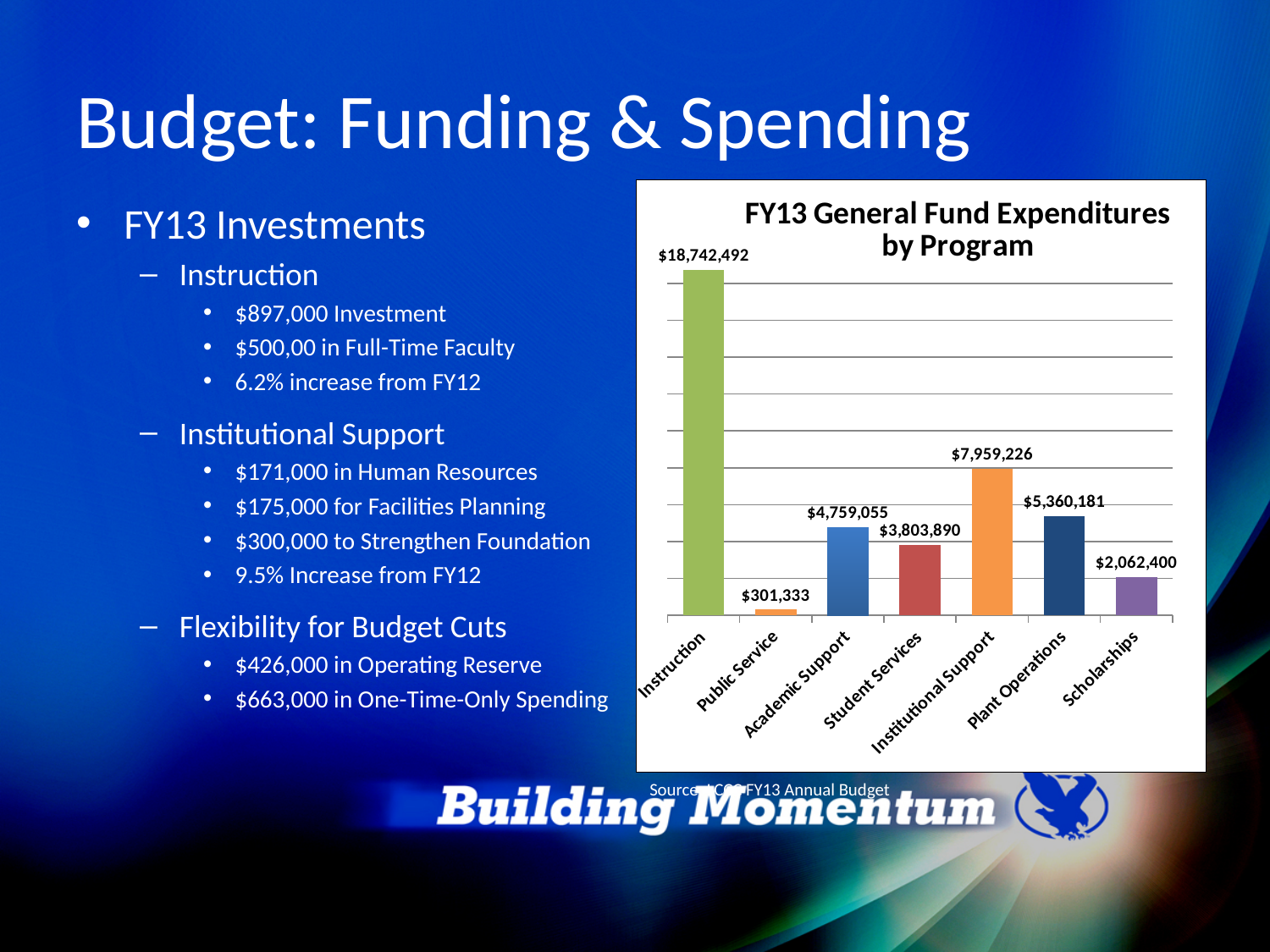
What is the difference between the Academic Support and Student Services values? $955,165 What is the title of the chart on the slide? FY13 General Fund Expenditures by Program What is the value for Instruction in the FY13 General Fund Expenditures by Program chart? $18,742,492 What is the value for Student Services in the chart? $3,803,890 What is the difference between the Institutional Support and Plant Operations values? $2,599,045 Which program has the lowest expenditure in the chart? Public Service What is the value for Institutional Support in the chart? $7,959,226 What is the value for Scholarships in the chart? $2,062,400 Which is larger, the value for Plant Operations or the value for Academic Support? Plant Operations Which program has the highest expenditure in the chart? Instruction How many programs are shown in the chart? 7 What kind of chart is shown on the slide? Bar chart